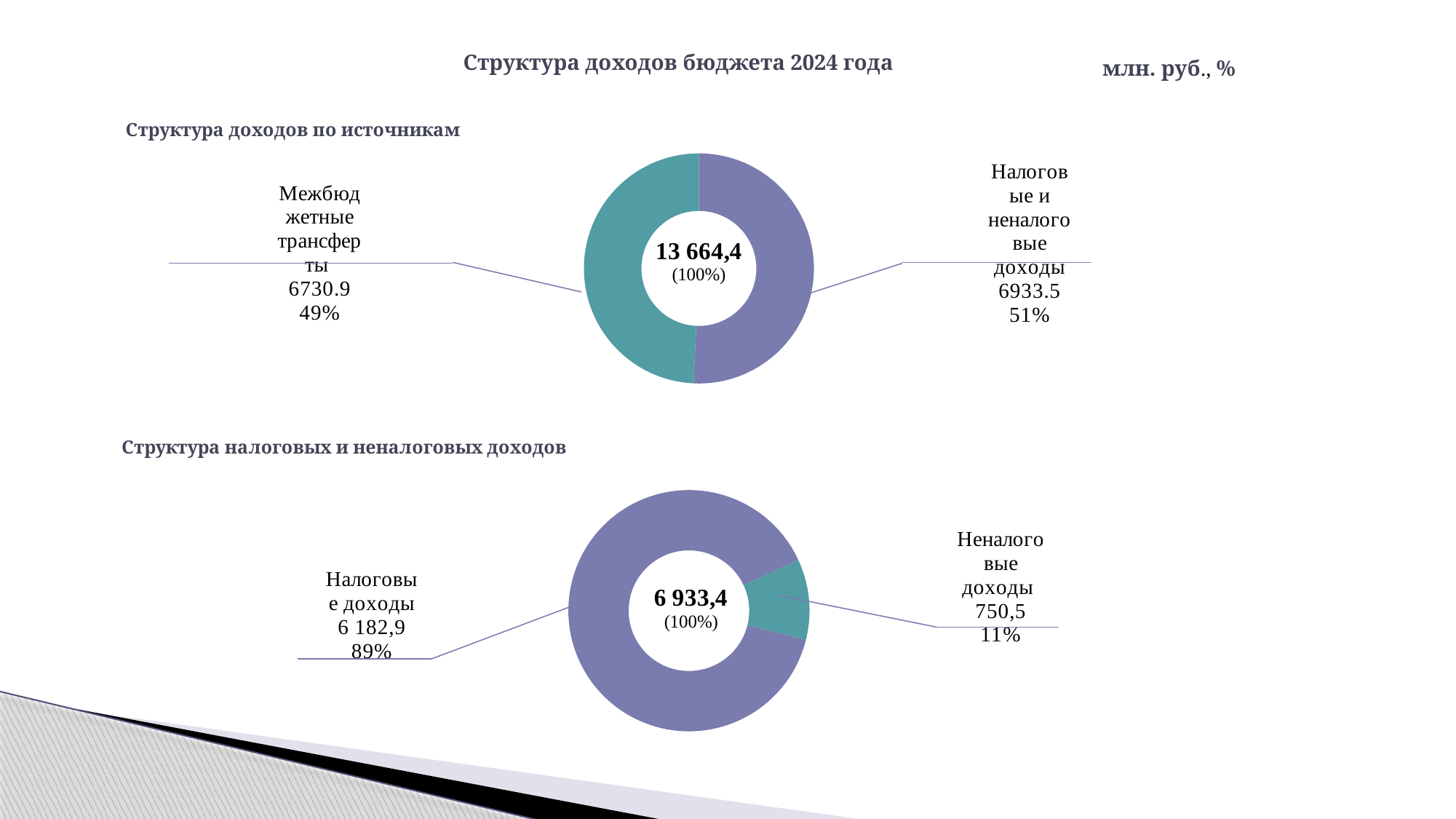
In the chart 'Структура налоговых и неналоговых доходов', which category is the smallest? Неналоговые доходы In the chart 'Структура доходов по источникам', how many categories are shown? 2 In the chart 'Структура налоговых и неналоговых доходов', what is the value for Неналоговые доходы? 750,5 What kind of chart is 'Структура налоговых и неналоговых доходов'? Doughnut chart In the chart 'Структура доходов по источникам', what total is shown in the centre of the doughnut? 13 664,4 In the chart 'Структура доходов по источникам', what is the value for Межбюджетные трансферты? 6730.9 In the chart 'Структура доходов по источникам', what colour is the Межбюджетные трансферты segment? Teal (green) In the chart 'Структура доходов по источникам', which category is larger: Межбюджетные трансферты or Налоговые и неналоговые доходы? Налоговые и неналоговые доходы What is the main title of the slide above the two charts? Структура доходов бюджета 2024 года In the chart 'Структура налоговых и неналоговых доходов', what total is shown in the centre of the doughnut? 6 933,4 In the chart 'Структура налоговых и неналоговых доходов', what share do Налоговые доходы make up? 89% In the chart 'Структура доходов по источникам', what share do Налоговые и неналоговые доходы make up? 51%